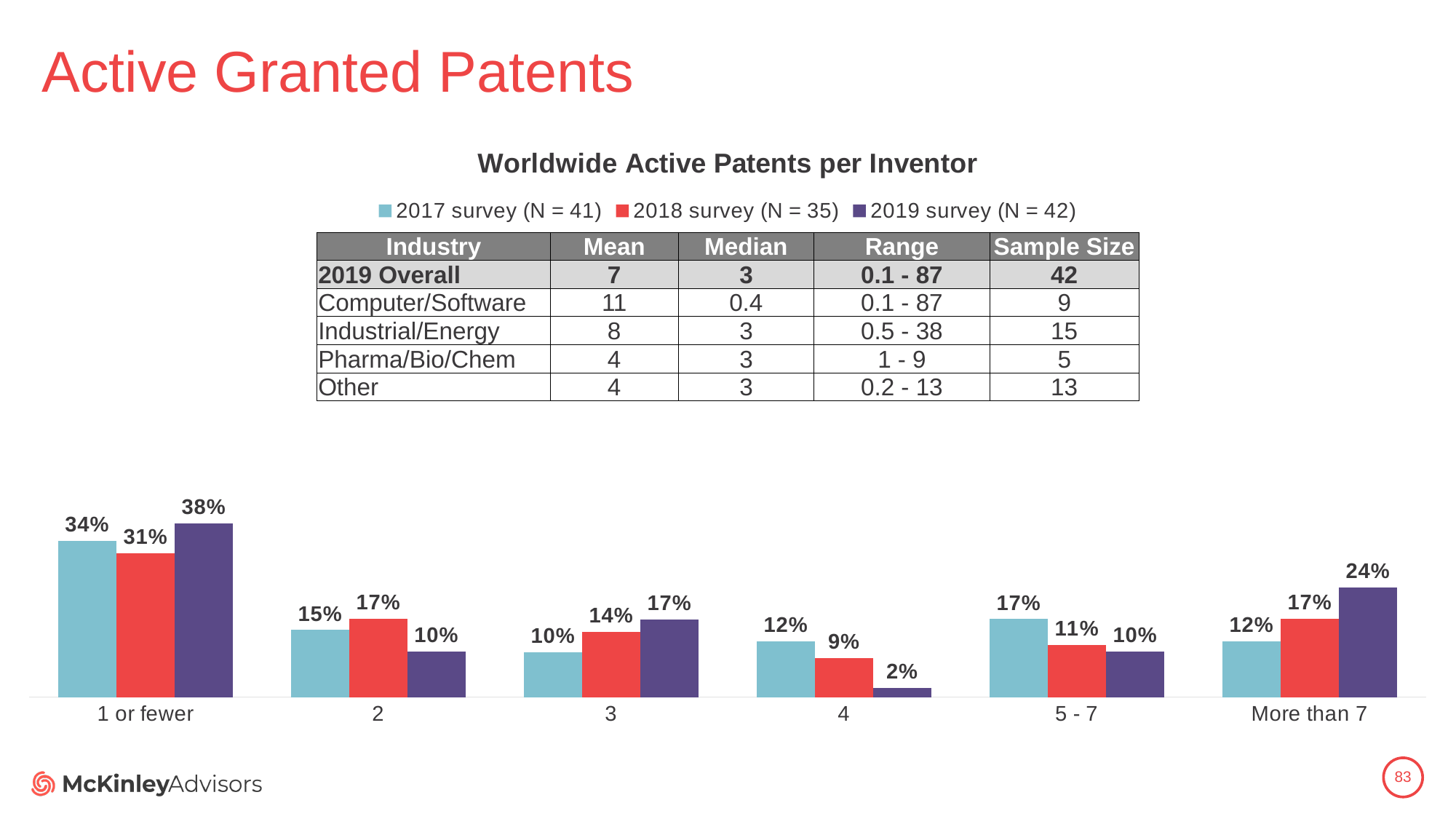
Which category has the highest value for the 2019 survey? 1 or fewer What is the value for the 2019 survey in the '1 or fewer' category? 38% What kind of chart is shown on the slide? Bar chart What is the sample size for the 2018 survey according to the legend? N = 35 What is the title of the chart? Worldwide Active Patents per Inventor Which category has the lowest value for the 2019 survey? 4 Which is larger in the '2' category: the 2018 survey value or the 2019 survey value? 2018 survey What is the value for the 2018 survey in the '4' category? 9% How many categories are shown on the x axis of the chart? 6 How many series does the chart legend list? 3 What is the difference between the 2019 survey and 2017 survey values in the 'More than 7' category? 12% What is the value for the 2017 survey in the '5 - 7' category? 17%